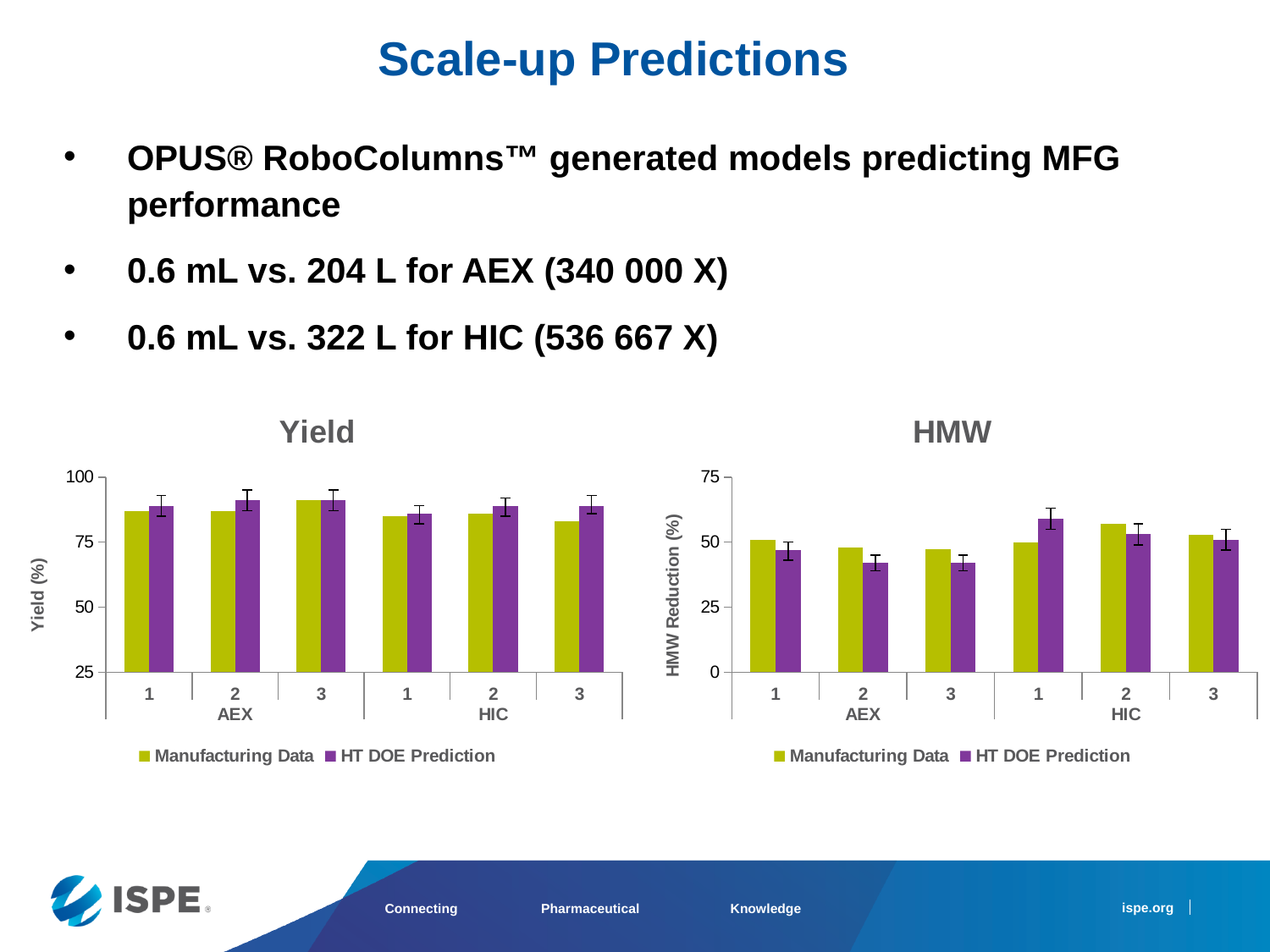
How many bar groups (categories) are shown on the Yield chart? 6 In the HMW chart, is the HT DOE Prediction value for HIC 1 greater or less than 50? greater In the HMW chart, for HIC 1, which is larger: Manufacturing Data or HT DOE Prediction? HT DOE Prediction In the HMW chart, for AEX 2, which is larger: Manufacturing Data or HT DOE Prediction? Manufacturing Data In the Yield chart, for HIC 3, which is larger: Manufacturing Data or HT DOE Prediction? HT DOE Prediction What kind of chart is the Yield chart? bar chart In the HMW chart, is the Manufacturing Data value for HIC 2 greater or less than 50? greater What is the y-axis title of the HMW chart? HMW Reduction (%) What are the two legend entries of the Yield chart? Manufacturing Data and HT DOE Prediction In the HMW chart, is the HT DOE Prediction value for AEX 2 greater or less than 50? less How many series does the legend of the HMW chart list? 2